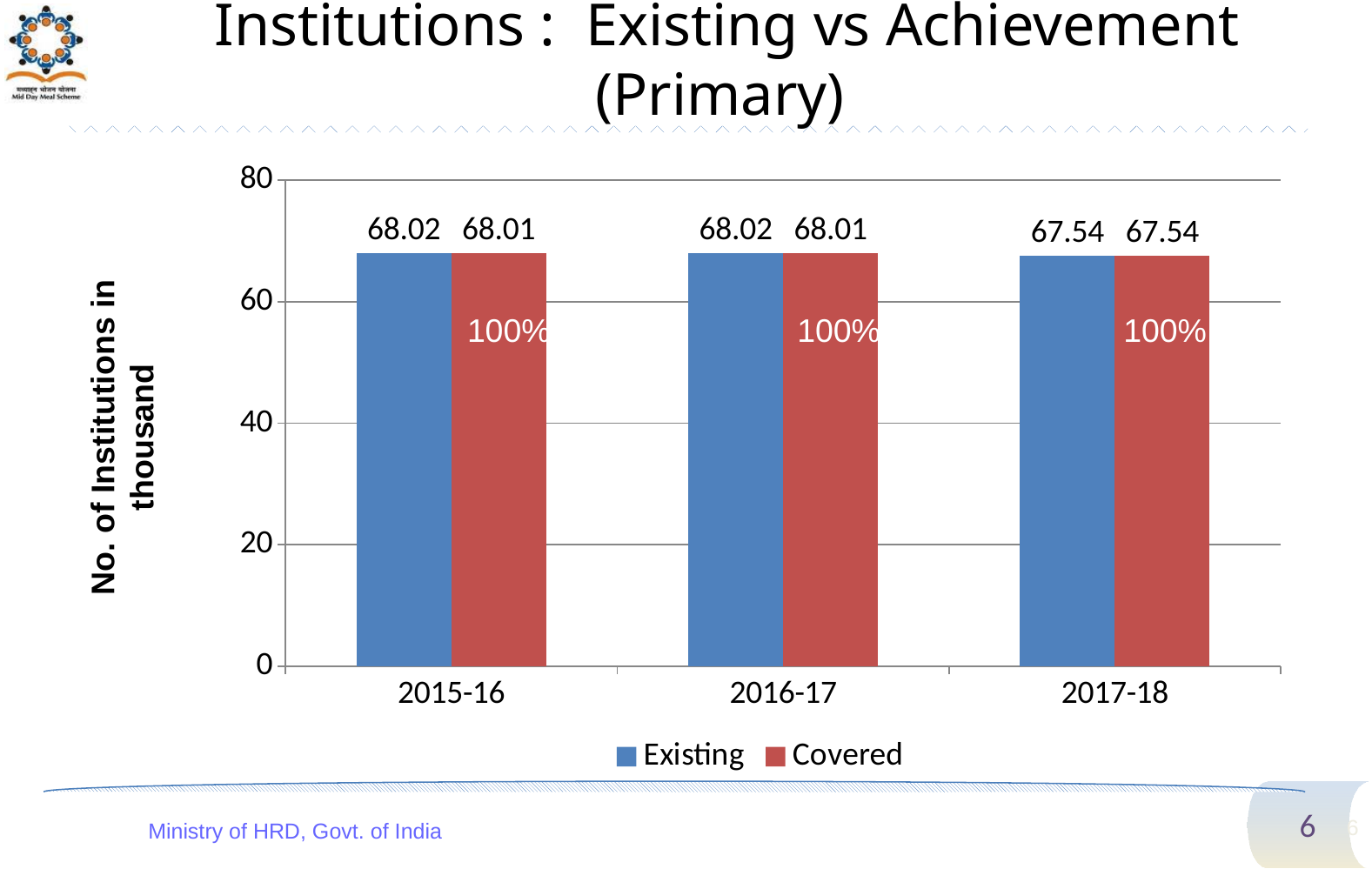
What is the value for Existing in 2015-16? 68.02 What is the difference between the Existing value in 2016-17 and the Existing value in 2017-18? 0.48 How many year categories are shown on the x axis? 3 What is the value for Covered in 2016-17? 68.01 Is the value for Existing in 2016-17 greater or less than 60? greater What is the label of the y axis? No. of Institutions in thousand How many series does the legend list? 2 What percentage label is shown on the Covered bar for 2015-16? 100% What is the difference between the Existing and Covered values in 2015-16? 0.01 What is the value for Existing in 2017-18? 67.54 What is the value for Covered in 2017-18? 67.54 What kind of chart is shown on the slide? bar chart